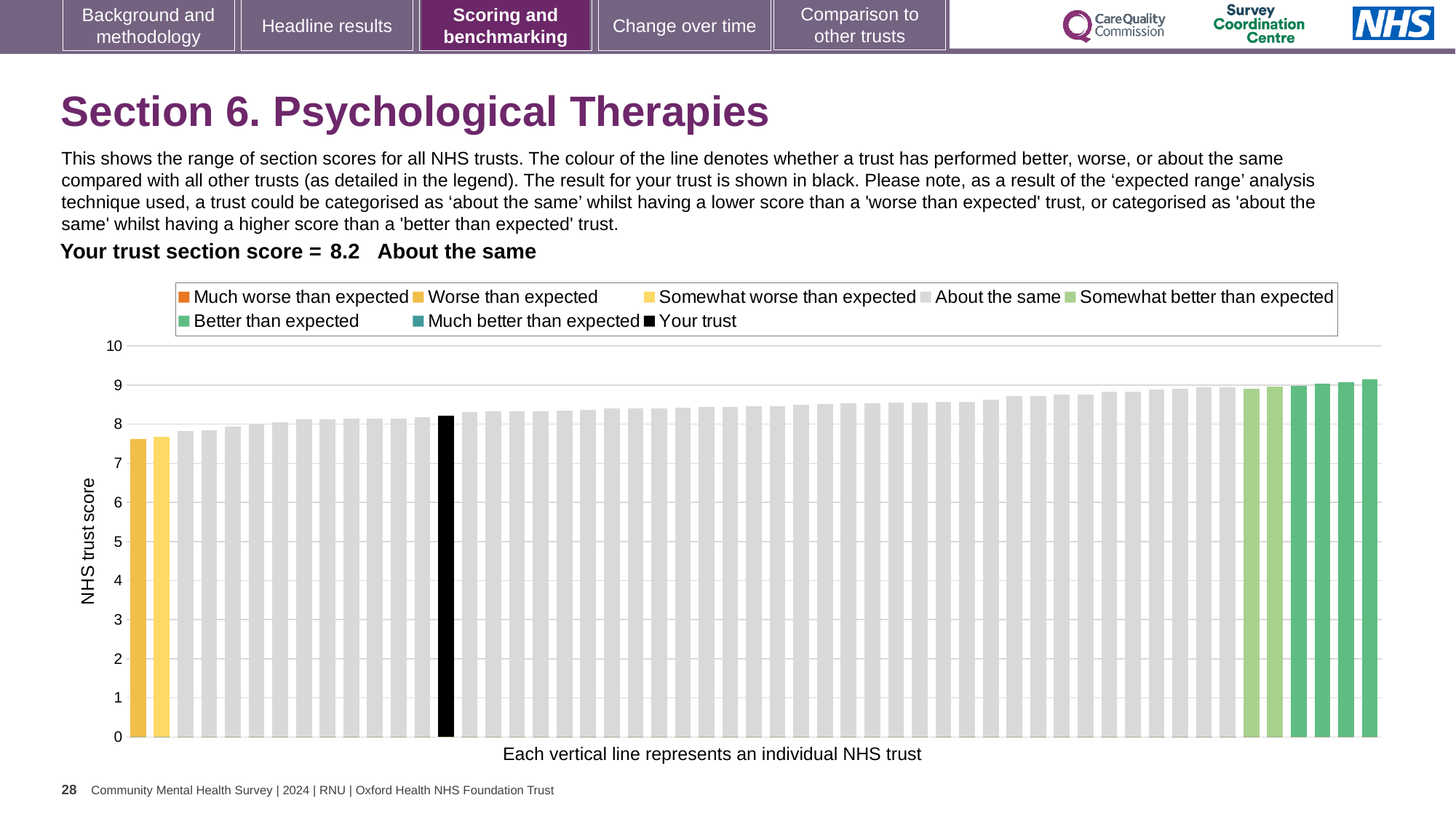
What kind of chart is shown on the slide? bar chart Is the value of the rightmost (highest) bar greater or less than 9? greater Do the bar values rise or fall from left to right along the x axis? rise How many bars are coloured as 'Worse than expected' (yellow)? 1 Is the value for your trust (the black bar) greater or less than 8? greater How many entries does the chart legend list? 8 What colour is the bar representing your trust? black What is the label on the vertical axis of the chart? NHS trust score What is the section score for your trust shown on the slide? 8.2 Which performance category is your trust placed in for this section? About the same How many bars are coloured as 'Better than expected' (green)? 4 Is the value of the leftmost (lowest) bar greater or less than 8? less